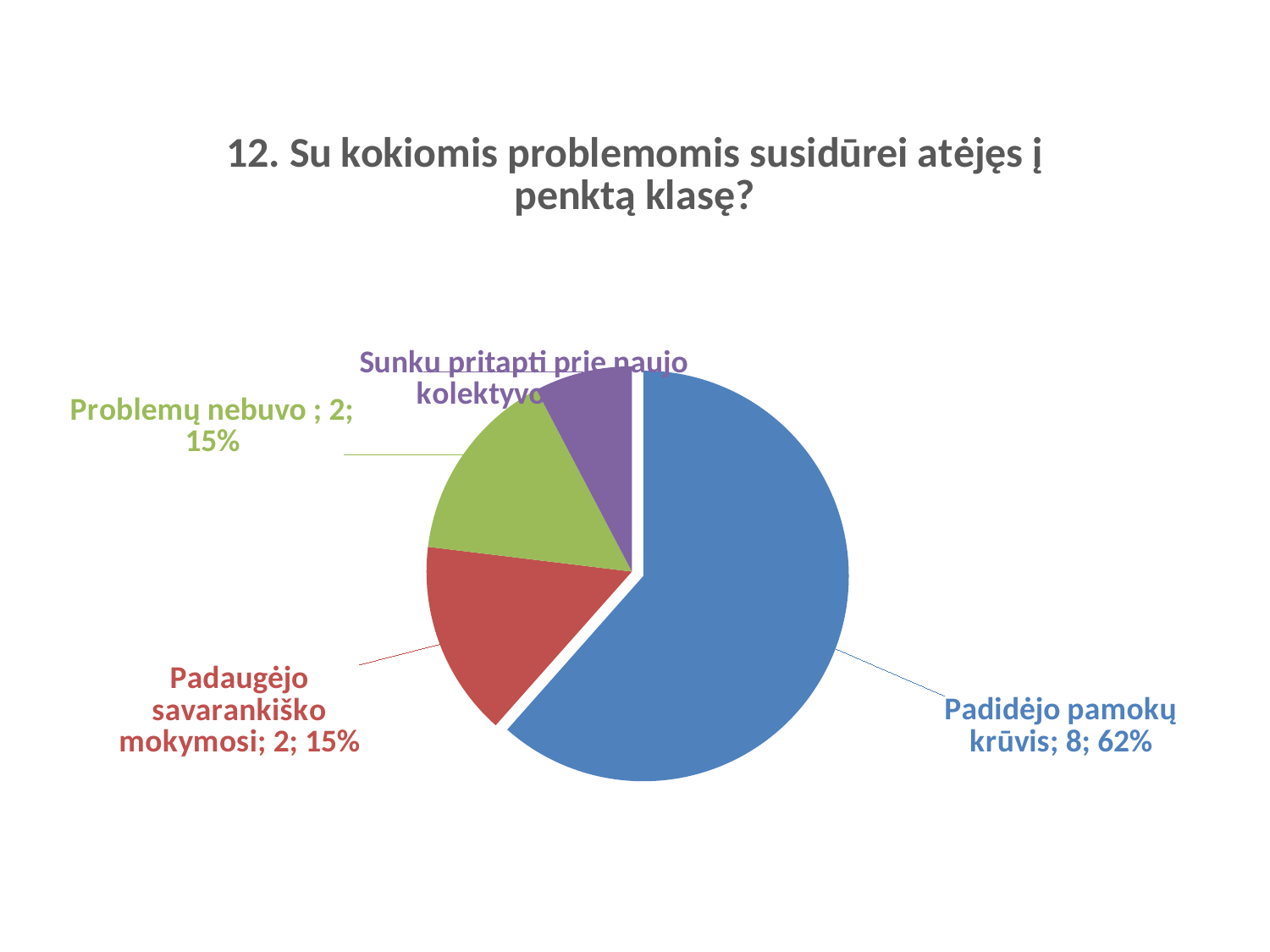
What is the title of the chart? 12. Su kokiomis problemomis susidūrei atėjęs į penktą klasę? What share of the pie does "Padidėjo pamokų krūvis" take? 62% What kind of chart is shown on the slide? pie chart What is the value for "Padidėjo pamokų krūvis"? 8 What percentage is shown for "Problemų nebuvo"? 15% What colour is the slice for "Padidėjo pamokų krūvis"? blue Which category has the largest slice? Padidėjo pamokų krūvis What is the value for "Padaugėjo savarankiško mokymosi"? 2 Which is larger, the value for "Padidėjo pamokų krūvis" or for "Problemų nebuvo"? Padidėjo pamokų krūvis How many slices does the pie chart have? 4 What is the difference between the values for "Padidėjo pamokų krūvis" and "Padaugėjo savarankiško mokymosi"? 6